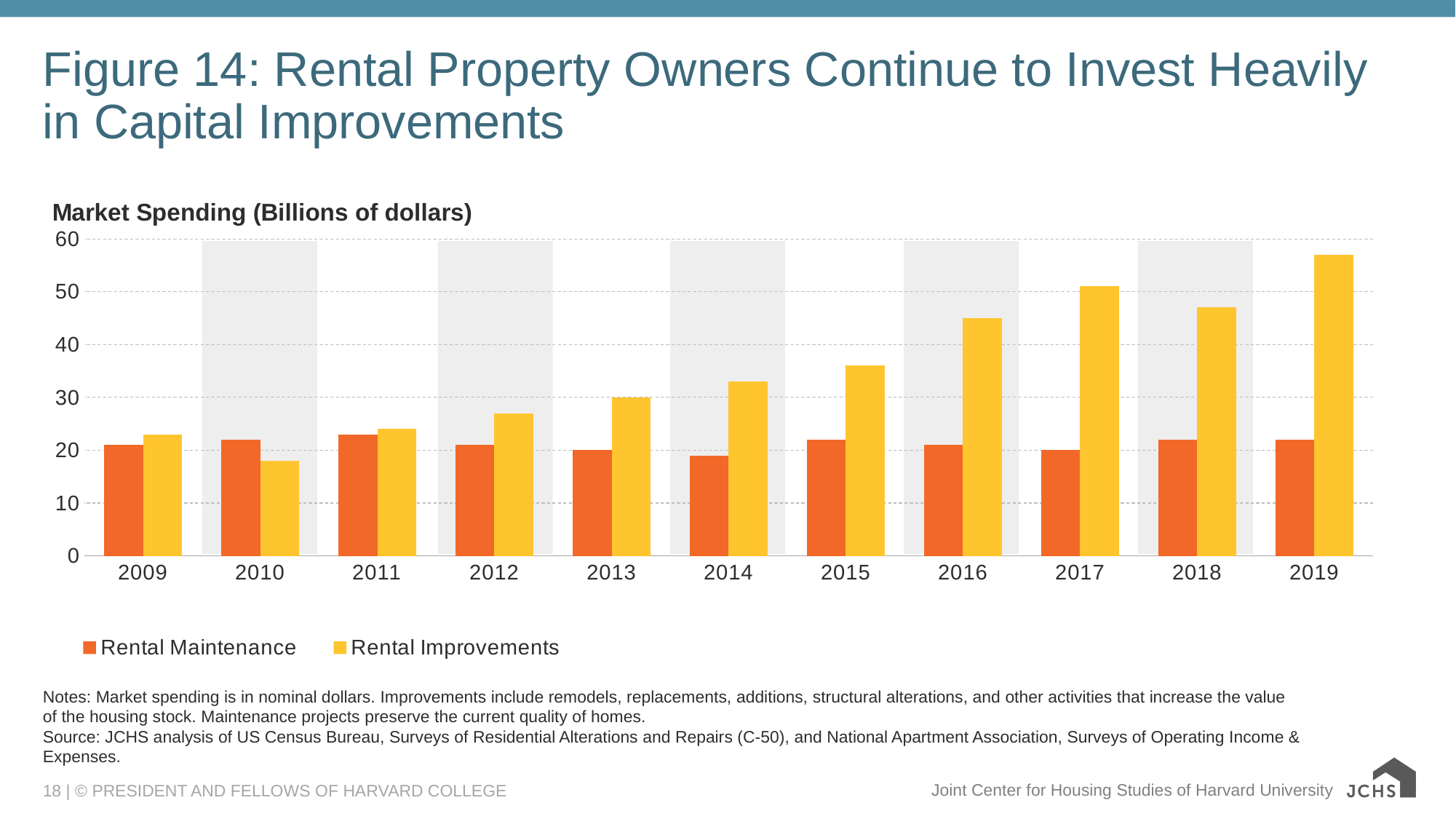
Is the value for Rental Improvements in 2016 greater or less than 40? greater What kind of chart is shown on the slide? Bar chart Is the value for Rental Maintenance in 2011 greater or less than 30? less Is the value for Rental Improvements in 2019 greater or less than 50? greater Does Rental Improvements spending generally rise or fall from 2010 to 2019? Rise What is the title printed above the chart? Market Spending (Billions of dollars) In which year is Rental Improvements spending highest? 2019 How many years are shown on the x axis? 11 How many series does the legend list? 2 In 2010, which is larger: Rental Maintenance or Rental Improvements? Rental Maintenance In which year is Rental Improvements spending lowest? 2010